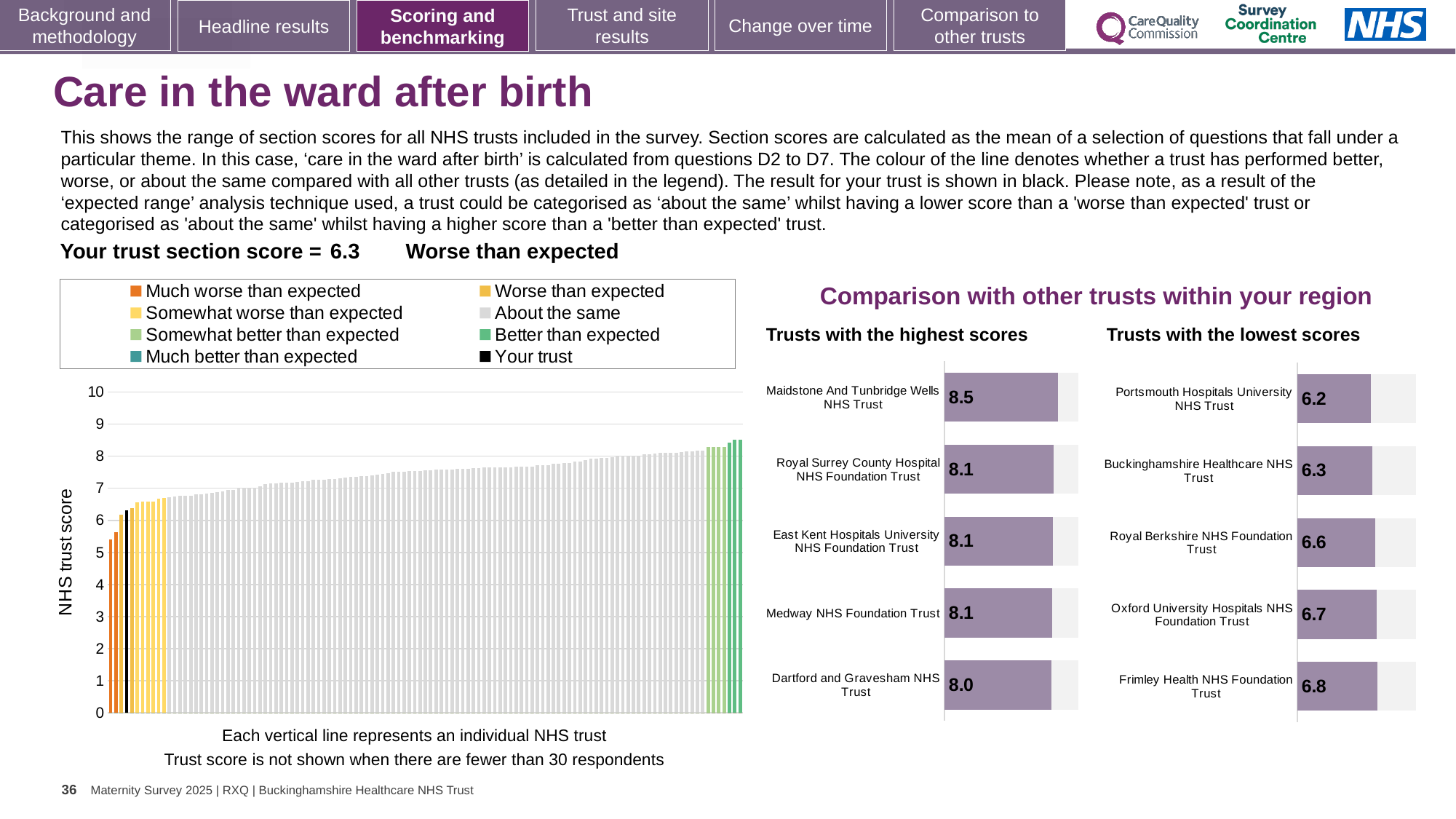
In the 'Trusts with the lowest scores' chart, which trust has the lowest score? Portsmouth Hospitals University NHS Trust In the large chart on the left, do the trust scores rise or fall from left to right? Rise In the 'Trusts with the highest scores' chart, what is the difference between the scores of Maidstone And Tunbridge Wells NHS Trust and Dartford and Gravesham NHS Trust? 0.5 In the 'Trusts with the lowest scores' chart, what is the difference between the scores of Frimley Health NHS Foundation Trust and Portsmouth Hospitals University NHS Trust? 0.6 In the 'Trusts with the lowest scores' chart, which has the larger score: Oxford University Hospitals NHS Foundation Trust or Buckinghamshire Healthcare NHS Trust? Oxford University Hospitals NHS Foundation Trust In the 'Trusts with the lowest scores' chart, what is the score for Royal Berkshire NHS Foundation Trust? 6.6 In the 'Trusts with the highest scores' chart, what is the score for Dartford and Gravesham NHS Trust? 8.0 What kind of chart is the large chart on the left showing NHS trust scores? Bar chart In the 'Trusts with the highest scores' chart, what is the score for Maidstone And Tunbridge Wells NHS Trust? 8.5 How many trusts are shown in the 'Trusts with the lowest scores' chart? 5 In the 'Trusts with the highest scores' chart, which trust has the highest score? Maidstone And Tunbridge Wells NHS Trust How many entries does the legend of the large chart on the left list? 8